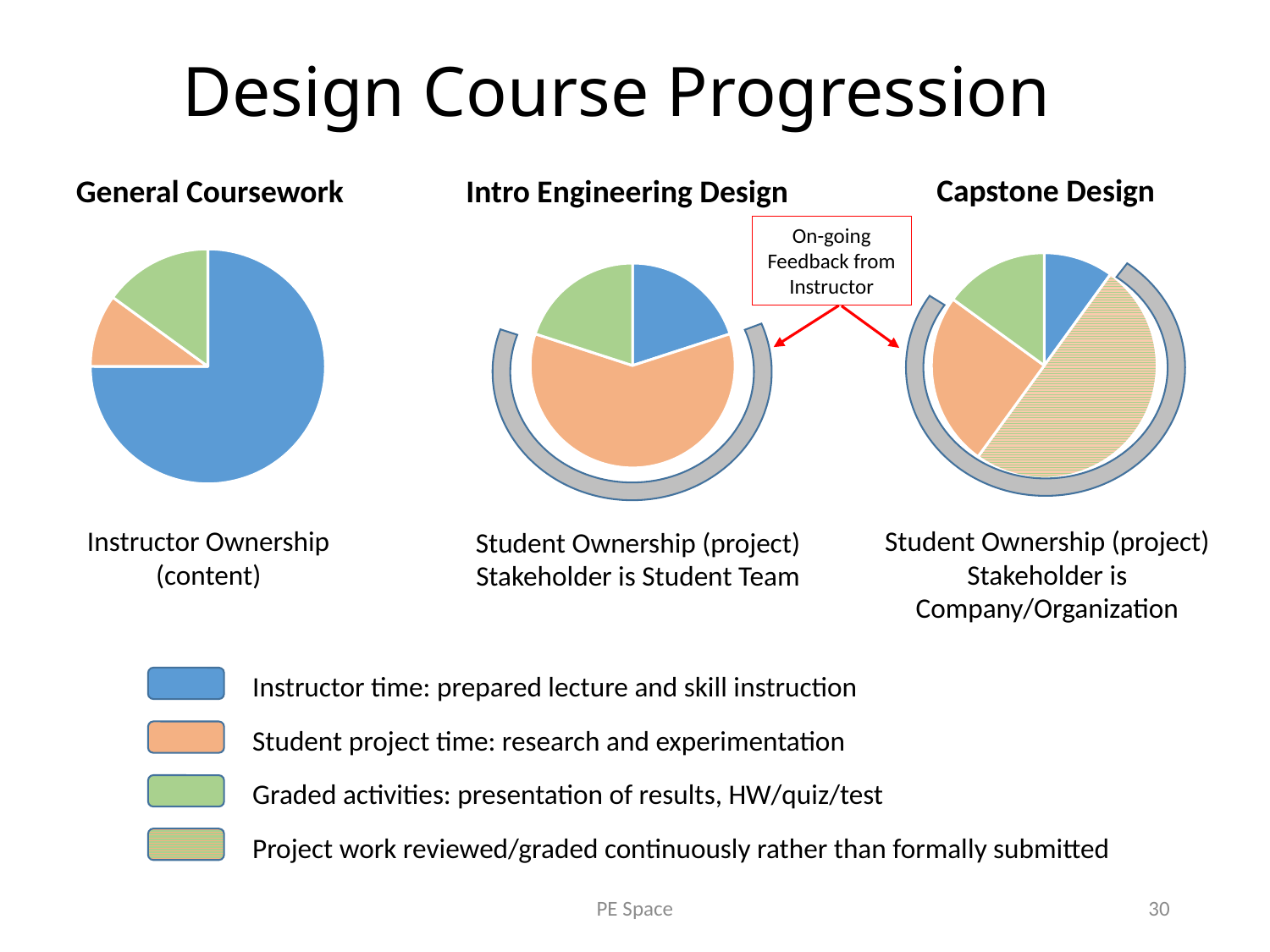
In the Intro Engineering Design pie chart, which is larger: the instructor time slice or the student project time slice? Student project time In the Capstone Design pie chart, how many slices are there? 4 What kind of chart is used for General Coursework, Intro Engineering Design and Capstone Design? Pie chart In the Intro Engineering Design pie chart, which category has the largest slice? Student project time: research and experimentation How many entries does the legend at the bottom of the slide list? 4 In the Capstone Design pie chart, which category has the smallest slice? Instructor time: prepared lecture and skill instruction In the General Coursework pie chart, how many slices are there? 3 What colour represents instructor time in the pie charts? Blue In the General Coursework pie chart, which category has the largest slice? Instructor time: prepared lecture and skill instruction How many pie charts are shown on the slide? 3 In the Capstone Design pie chart, which category has the largest slice? Project work reviewed/graded continuously rather than formally submitted In the General Coursework pie chart, which is larger: the instructor time slice or the graded activities slice? Instructor time